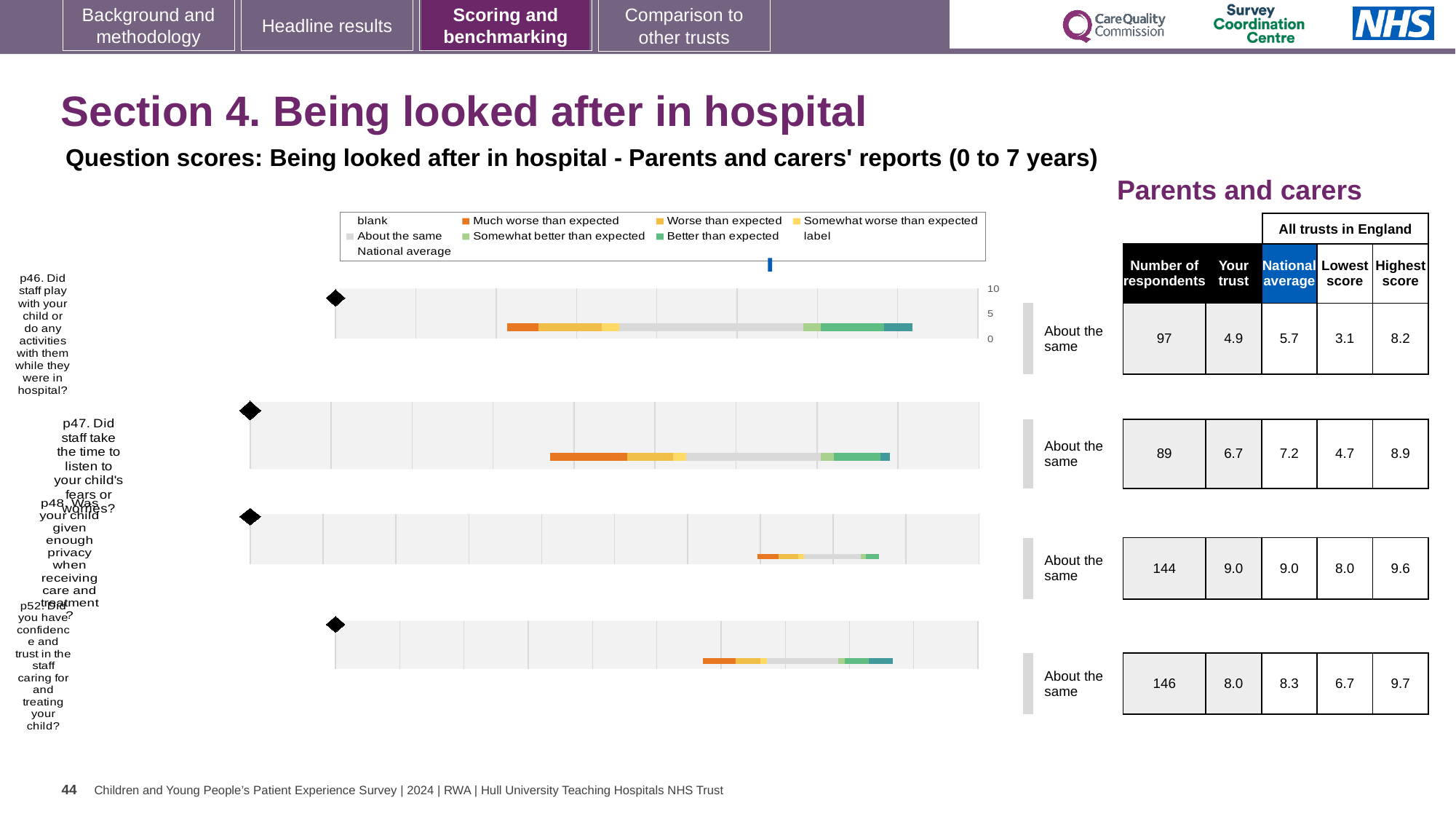
For p47, which is larger: the 'Your trust' score or the national average? National average For p52, what is the difference between the highest score and the lowest score across all trusts in England? 3.0 How many respondents answered p48 (Was your child given enough privacy when receiving care and treatment?)? 144 What benchmark category is shown for every question on this slide? About the same What is the lowest score across all trusts in England for p48? 8.0 For p46, what is the difference between the national average and the 'Your trust' score? 0.8 Which question has the lowest 'Your trust' score? p46 What is the 'Your trust' score for p46 (Did staff play with your child or do any activities with them while they were in hospital?)? 4.9 Which question has the highest 'Your trust' score? p48 What is the highest score across all trusts in England for p52 (Did you have confidence and trust in the staff caring for and treating your child?)? 9.7 What is the national average score for p47 (Did staff take the time to listen to your child's fears or worries?)? 7.2 How many questions are plotted on the chart? 4